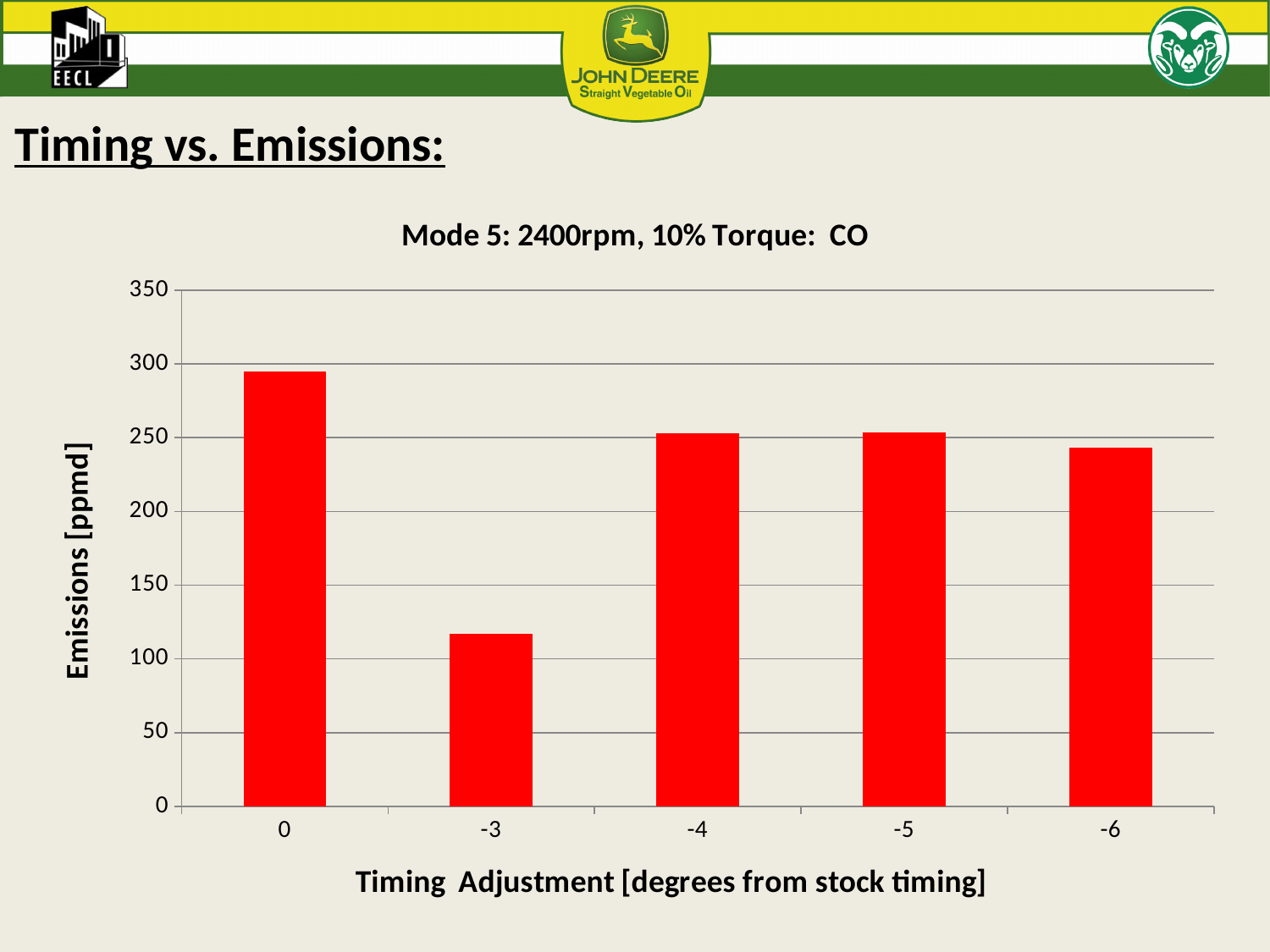
Is the emissions value for timing adjustment 0 greater or less than 250? greater How many timing adjustment categories are plotted on the x axis? 5 Is the emissions value for timing adjustment -6 greater or less than 200? greater What is the label of the y axis? Emissions [ppmd] Is the emissions value for timing adjustment -3 greater or less than 150? less What kind of chart is shown on the slide? bar chart Which has higher CO emissions, timing adjustment -3 or timing adjustment -6? -6 Which timing adjustment has the lowest CO emissions? -3 What is the title of the chart? Mode 5: 2400rpm, 10% Torque: CO Which has higher CO emissions, timing adjustment 0 or timing adjustment -4? 0 Which timing adjustment has the highest CO emissions? 0